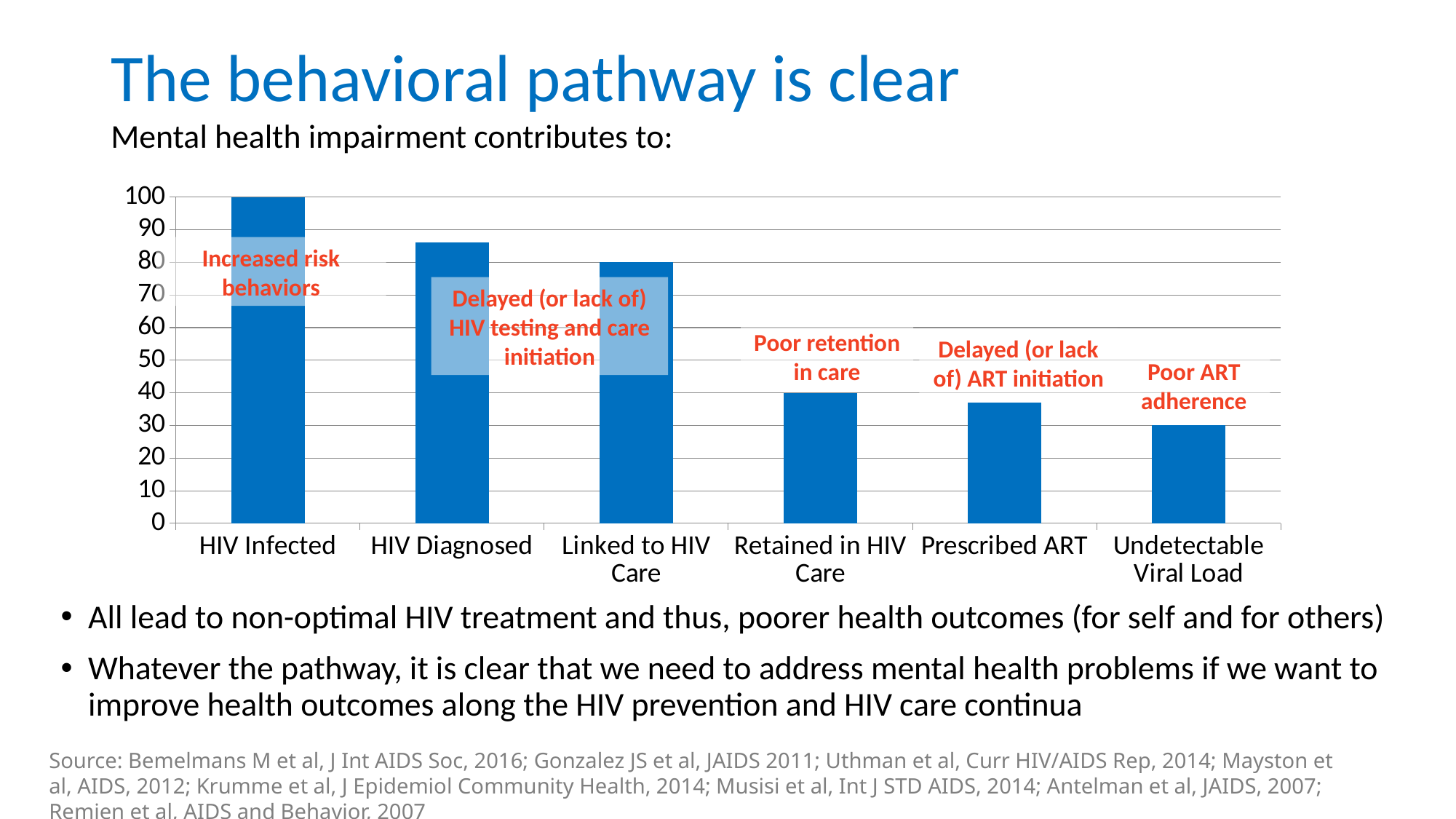
Do the bar values rise or fall from left to right along the x axis? fall Is the value for Prescribed ART greater or less than 40? less What red annotation is written over the HIV Infected bar? Increased risk behaviors What is the value for Retained in HIV Care? 40 Which category has the highest bar? HIV Infected What is the value for HIV Infected? 100 How many categories are shown on the x axis of the chart? 6 Which category has the lowest bar? Undetectable Viral Load What is the value for Undetectable Viral Load? 30 Is the value for HIV Diagnosed greater or less than 80? greater What is the value for Linked to HIV Care? 80 What type of chart is shown on the slide? bar chart